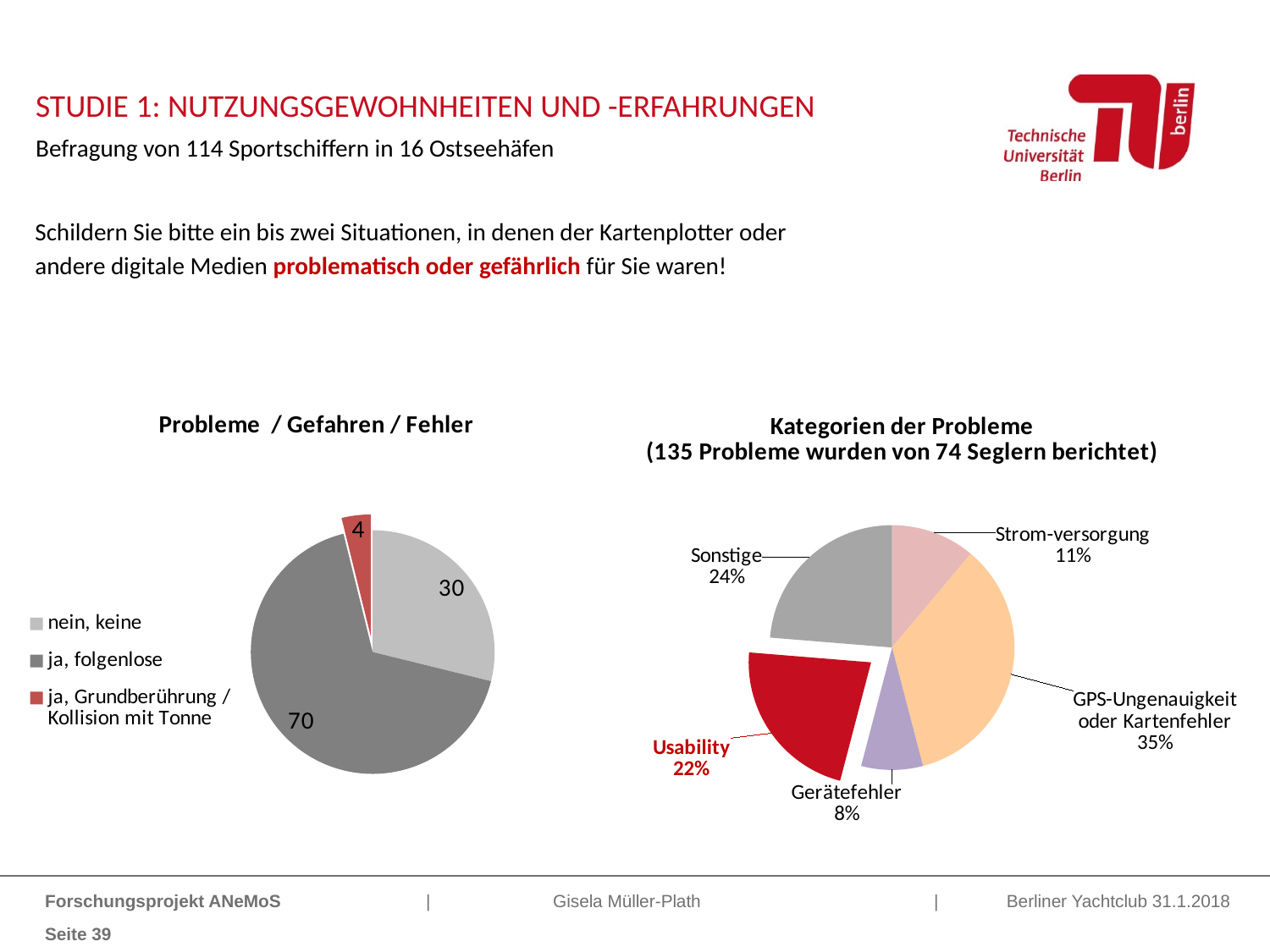
In the chart titled "Probleme / Gefahren / Fehler", what is the value for "ja, folgenlose"? 70 In the chart titled "Kategorien der Probleme", what share does "Usability" have? 22% In the chart titled "Probleme / Gefahren / Fehler", which category has the largest value? ja, folgenlose In the chart titled "Probleme / Gefahren / Fehler", how many categories does the legend list? 3 In the chart titled "Probleme / Gefahren / Fehler", what is the value for "nein, keine"? 30 In the chart titled "Kategorien der Probleme", which is larger: "Sonstige" or "Strom-versorgung"? Sonstige In the chart titled "Kategorien der Probleme", which category has the smallest share? Gerätefehler In the chart titled "Probleme / Gefahren / Fehler", what is the difference between the values for "ja, folgenlose" and "nein, keine"? 40 In the chart titled "Kategorien der Probleme", what is the difference between the shares of "Sonstige" and "Gerätefehler"? 16% In the chart titled "Probleme / Gefahren / Fehler", what is the value for "ja, Grundberührung / Kollision mit Tonne"? 4 What kind of chart is the chart titled "Kategorien der Probleme"? Pie chart In the chart titled "Kategorien der Probleme", what share does "GPS-Ungenauigkeit oder Kartenfehler" have? 35%